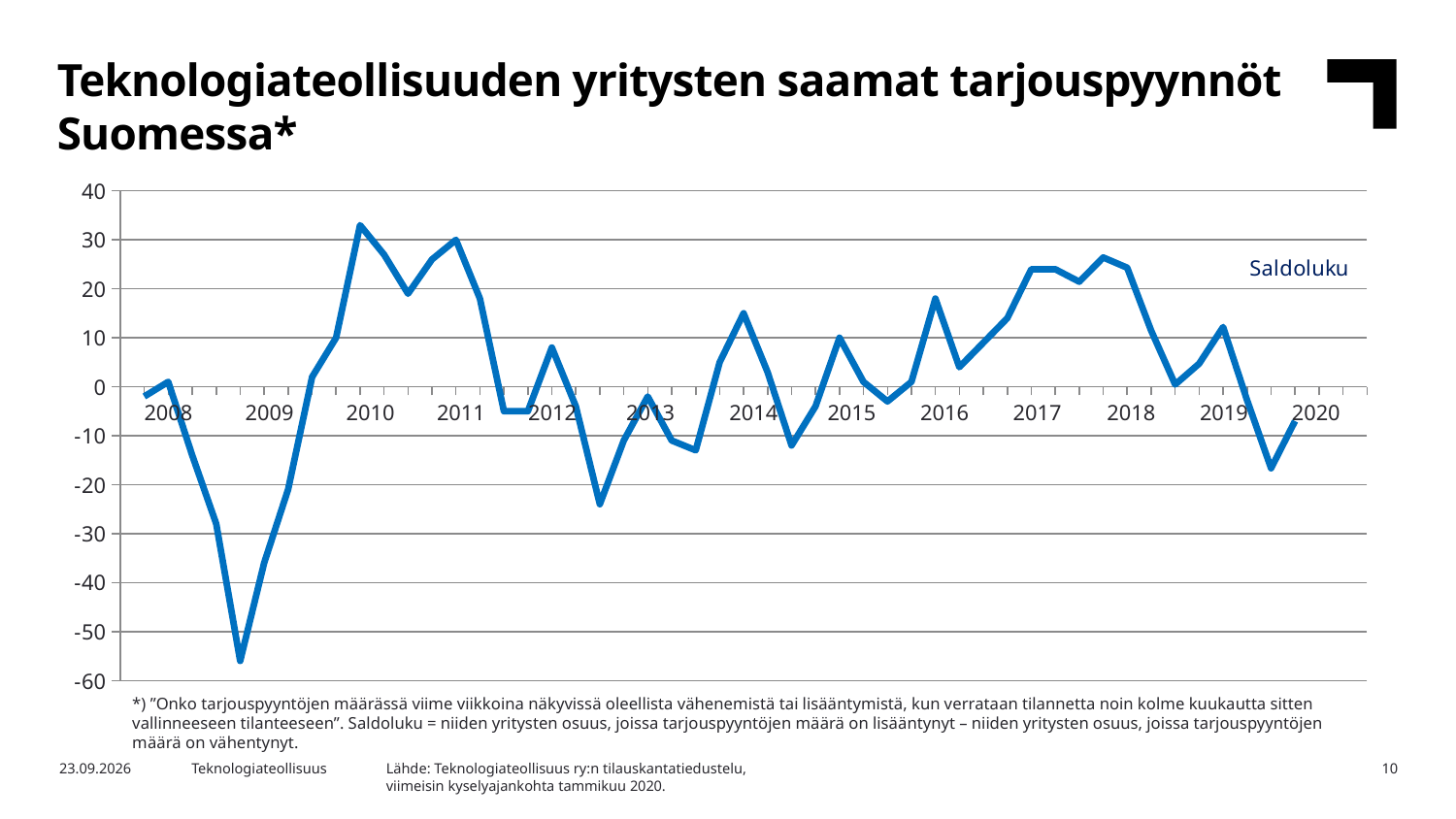
Does the Saldoluku line rise or fall between 2018 and 2020? fall Is the lowest value of the Saldoluku line greater or less than -50? less What is the title of the chart on the slide? Teknologiateollisuuden yritysten saamat tarjouspyynnöt Suomessa* Is the peak of the line around 2017 greater or less than 20? greater How many year labels are shown on the x axis? 13 How many series does the chart's legend list? 1 What is the name of the series shown in the chart legend? Saldoluku Is the dip of the line around 2012 greater or less than -20? less Does the Saldoluku line rise or fall between 2009 and 2010? rise What kind of chart is shown on the slide? line chart